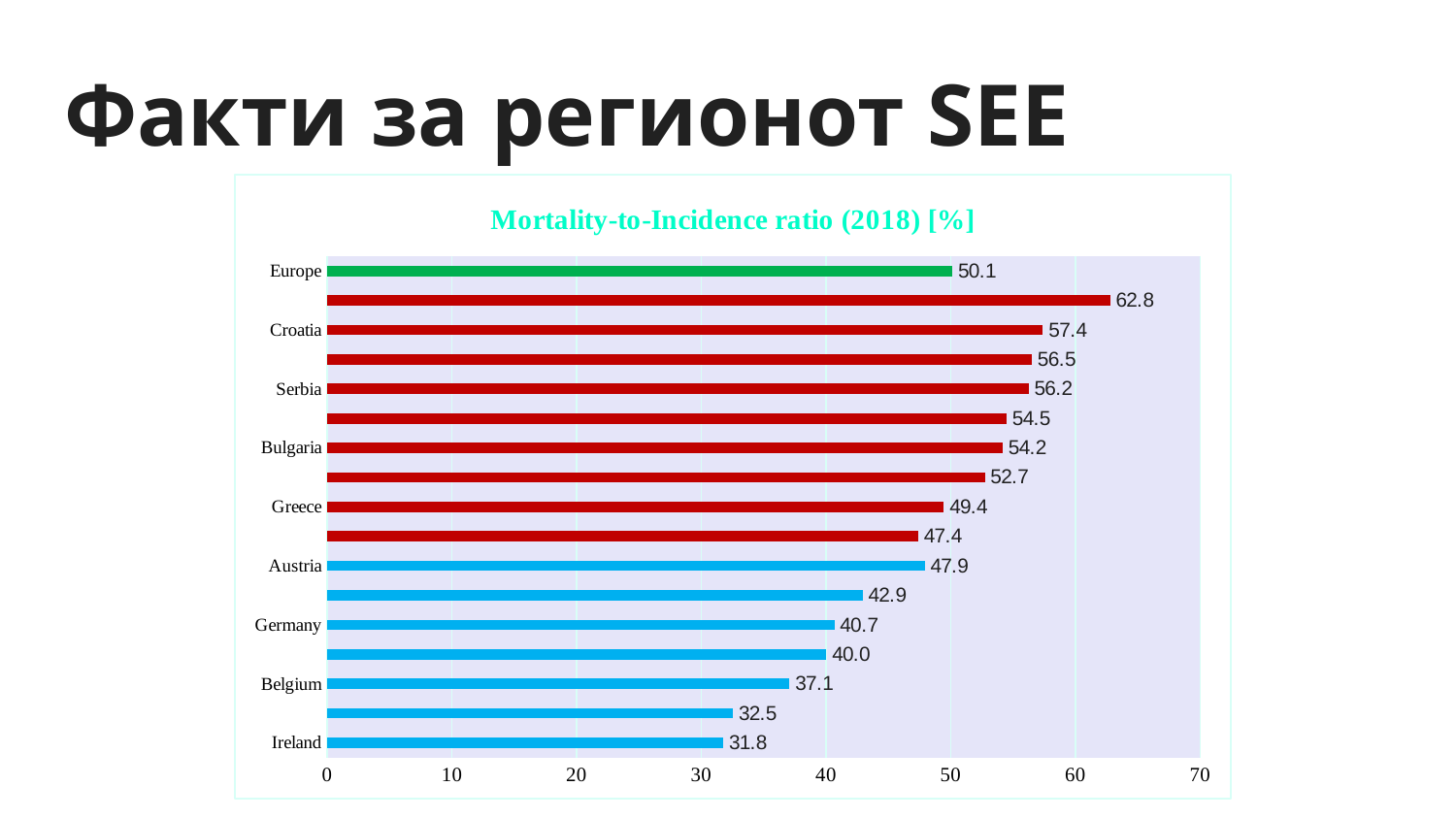
What is the value shown for Croatia? 57.4 How many bars are plotted in the chart? 17 What is the Mortality-to-Incidence ratio for Europe? 50.1 What is the difference between the values for Croatia and Serbia? 1.2 Is the value for Germany greater or less than 50? less What is the difference between the values for Europe and Ireland? 18.3 What is the value shown for Serbia? 56.2 Which has a higher value, Bulgaria or Greece? Bulgaria What is the value shown for Ireland? 31.8 What is the title of the chart? Mortality-to-Incidence ratio (2018) [%] What kind of chart is shown on the slide? bar chart Which labelled country has the lowest Mortality-to-Incidence ratio? Ireland